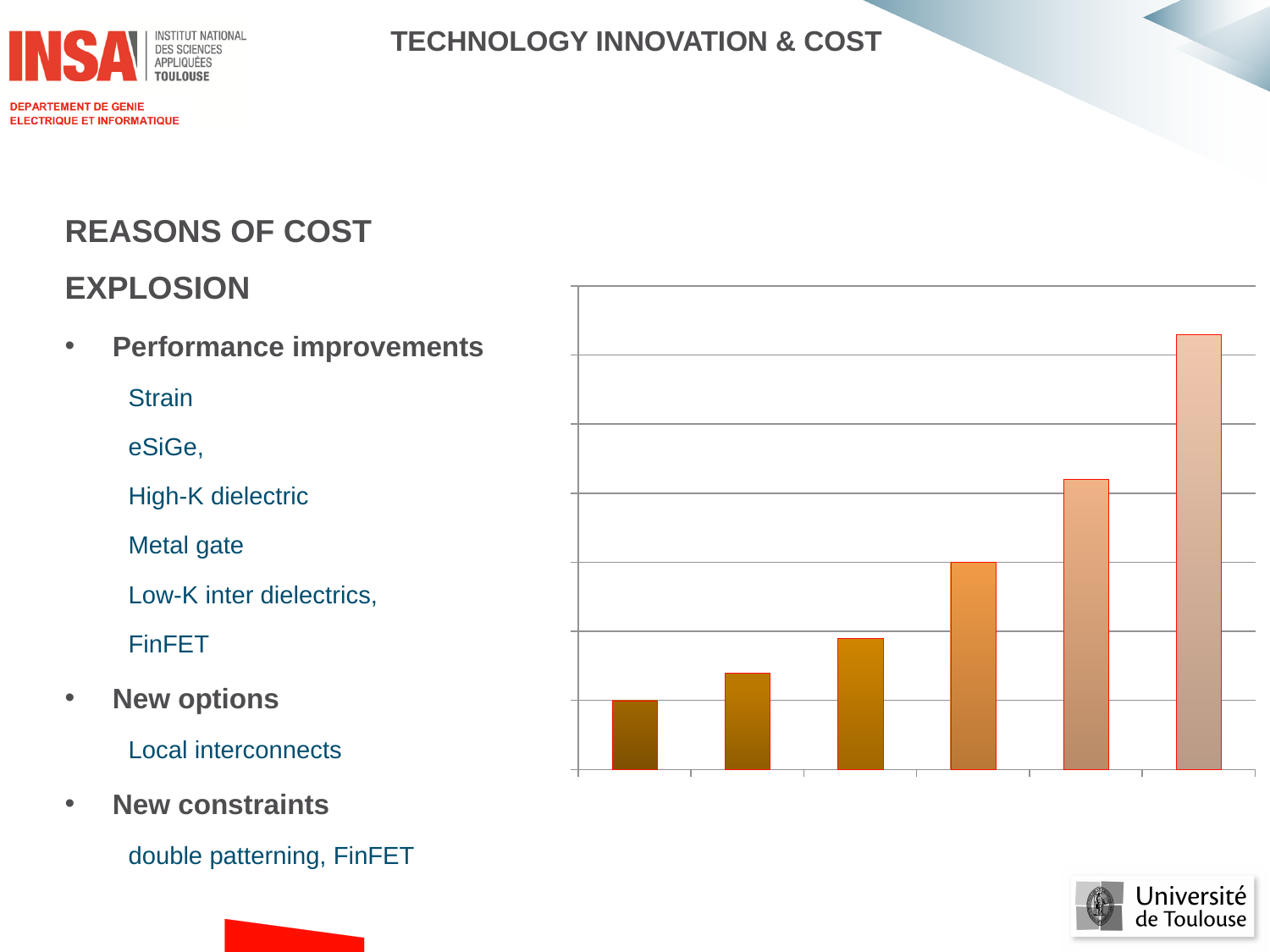
In the chart, is the second bar from the left taller or shorter than the third bar? shorter Do the bar heights in the chart rise or fall from left to right? rise Does the chart on the slide display a legend? No Which bar in the chart is the tallest, counting from the left? the sixth (rightmost) bar What kind of chart is shown on the right side of the slide? bar chart Which bar in the chart is the shortest, counting from the left? the first (leftmost) bar Are any numeric values or axis labels printed on the chart? No How many bars does the chart on the slide contain? 6 In the chart, is the fifth bar from the left taller or shorter than the fourth bar? taller